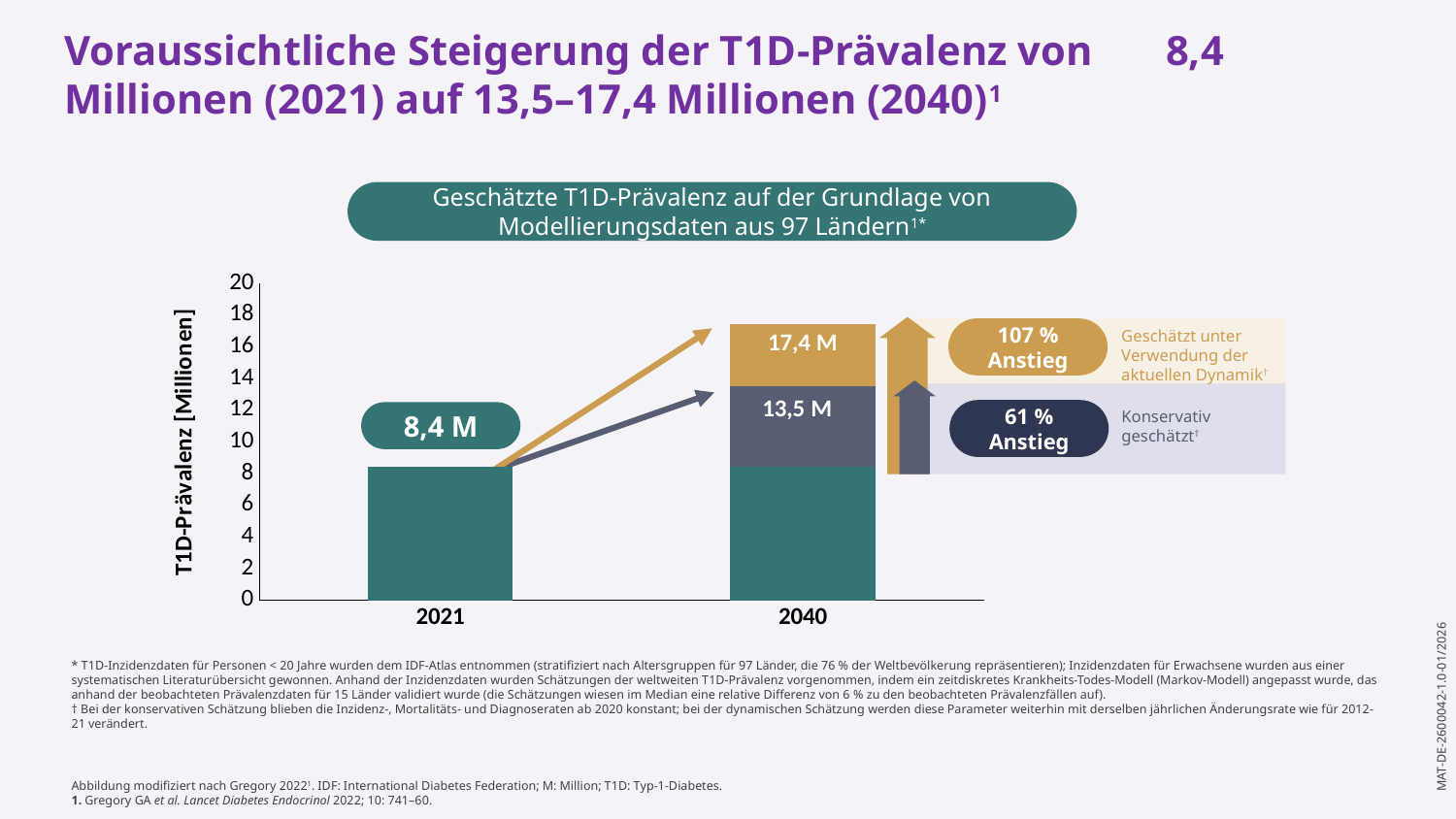
What type of chart is shown on the slide? Bar chart What is the label of the y axis? T1D-Prävalenz [Millionen] What is the conservative estimate of T1D prevalence for 2040? 13,5 M What is the difference between the conservative 2040 estimate (13,5 M) and the 2021 value (8,4 M)? 5,1 M What percentage increase is shown for the conservative estimate? 61 % Anstieg What is the difference between the 2040 estimate using current dynamics (17,4 M) and the 2021 value (8,4 M)? 9,0 M How many years are shown on the x axis? 2 What percentage increase is shown for the estimate using current dynamics? 107 % Anstieg Which year has the higher T1D prevalence, 2021 or 2040? 2040 What is the estimated T1D prevalence for 2040 using the current dynamics? 17,4 M What is the difference between the two 2040 estimates, 17,4 M and 13,5 M? 3,9 M What is the T1D prevalence shown for 2021? 8,4 M